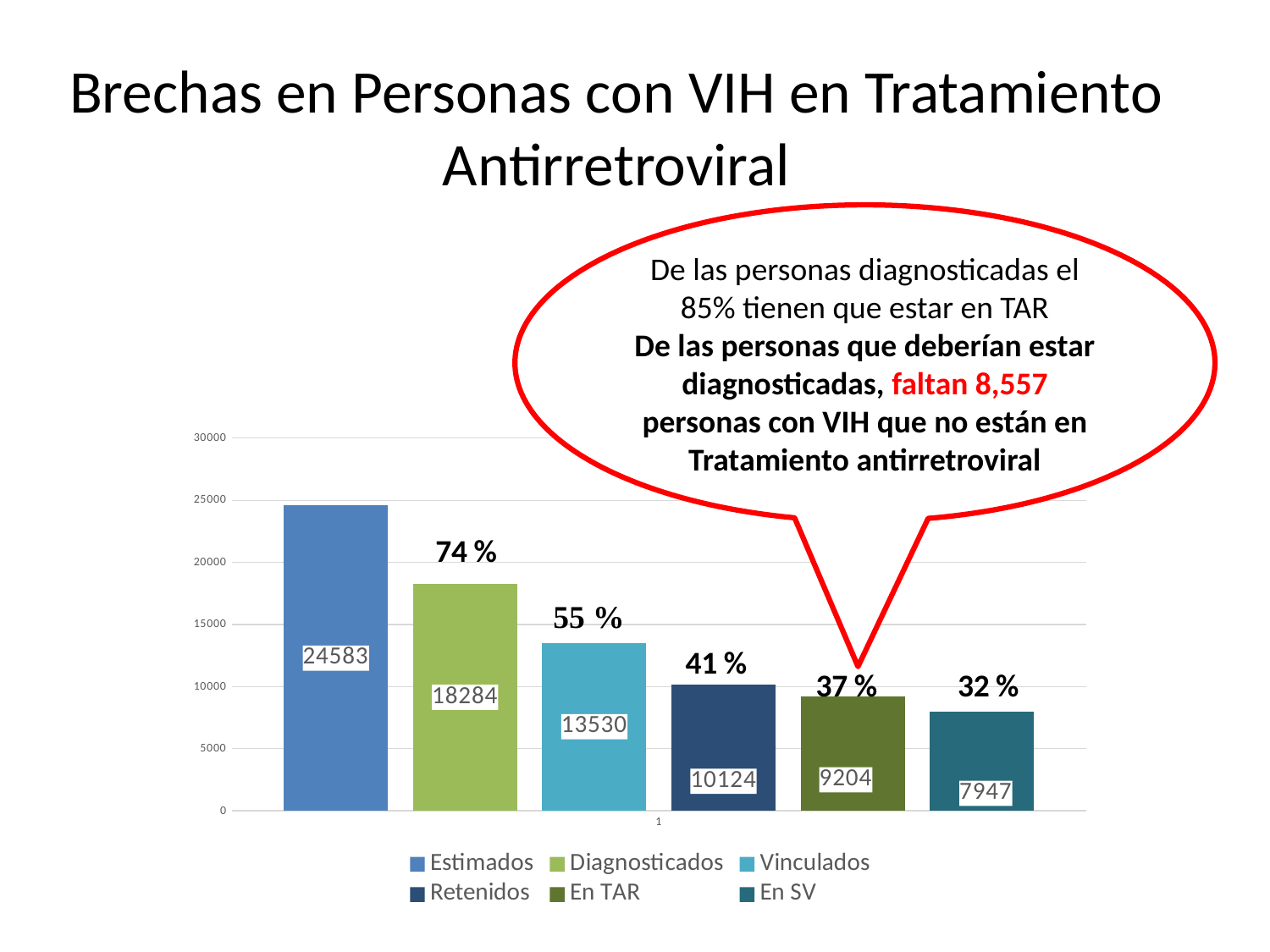
What is the value for Estimados? 24583 What kind of chart is shown on the slide? Bar chart What is the difference between the values for Estimados and Diagnosticados? 6299 What is the value for En TAR? 9204 How many series does the legend list? 6 What is the value for En SV? 7947 What is the value for Diagnosticados? 18284 What is the difference between the values for Vinculados and Retenidos? 3406 Which series has the lowest value? En SV What percentage is printed above the Vinculados bar? 55 % Which is larger, the value for Retenidos or the value for En TAR? Retenidos Which series has the highest value? Estimados